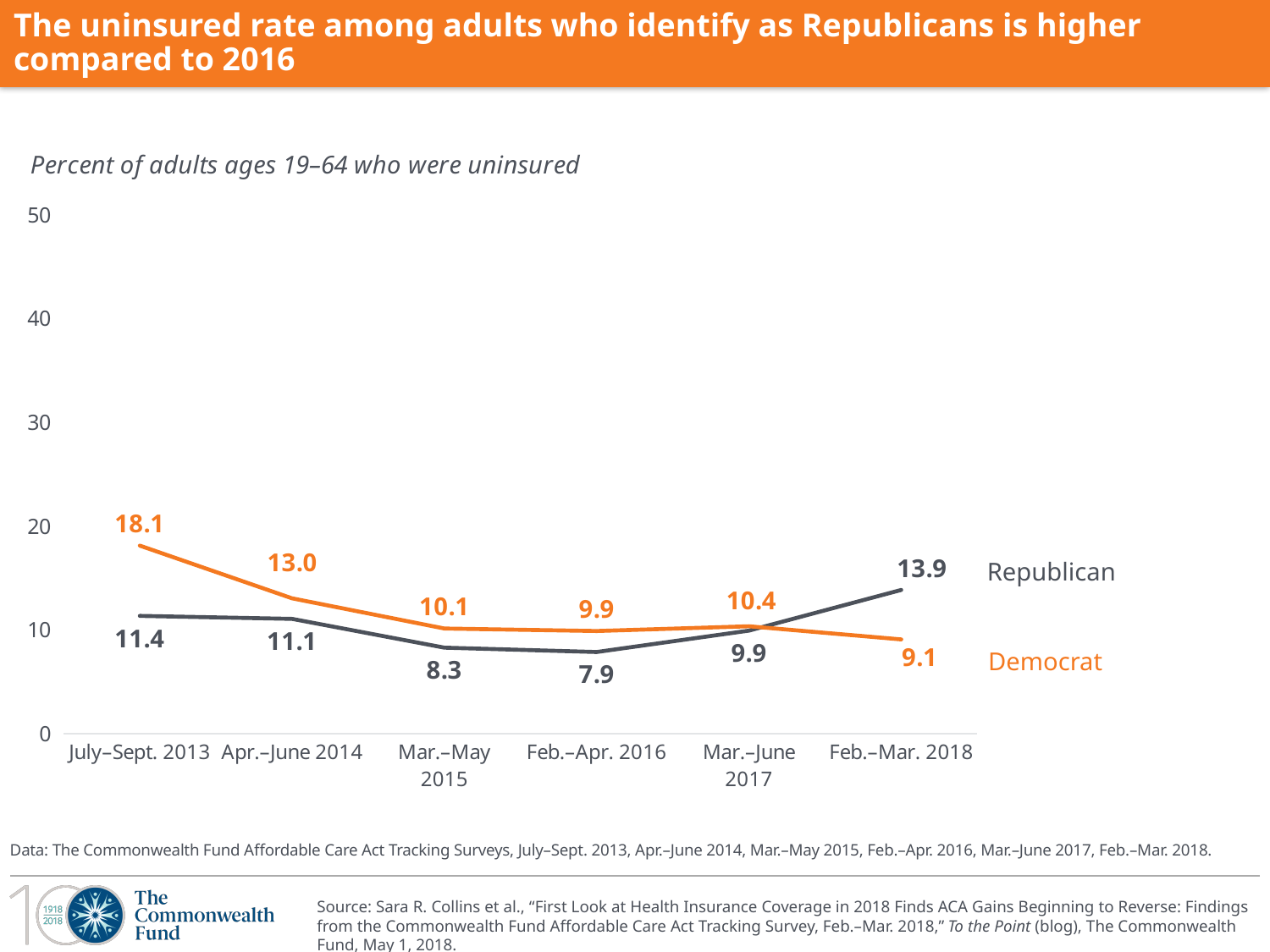
How many survey periods are shown on the x axis? 6 What was the uninsured rate for Republicans in Feb.–Apr. 2016? 7.9 In which survey period was the Republican uninsured rate highest? Feb.–Mar. 2018 What was the uninsured rate for Republicans in Feb.–Mar. 2018? 13.9 What was the uninsured rate for Democrats in Mar.–June 2017? 10.4 Did the Democrat uninsured rate rise or fall from July–Sept. 2013 to Mar.–May 2015? Fall How many series are plotted on the chart? 2 What was the uninsured rate for Democrats in July–Sept. 2013? 18.1 Which group had the higher uninsured rate in Apr.–June 2014, Democrats or Republicans? Democrats What is the difference between the Republican and Democrat uninsured rates in Feb.–Mar. 2018? 4.8 In which survey period was the Democrat uninsured rate lowest? Feb.–Mar. 2018 What type of chart is shown on the slide? Line chart